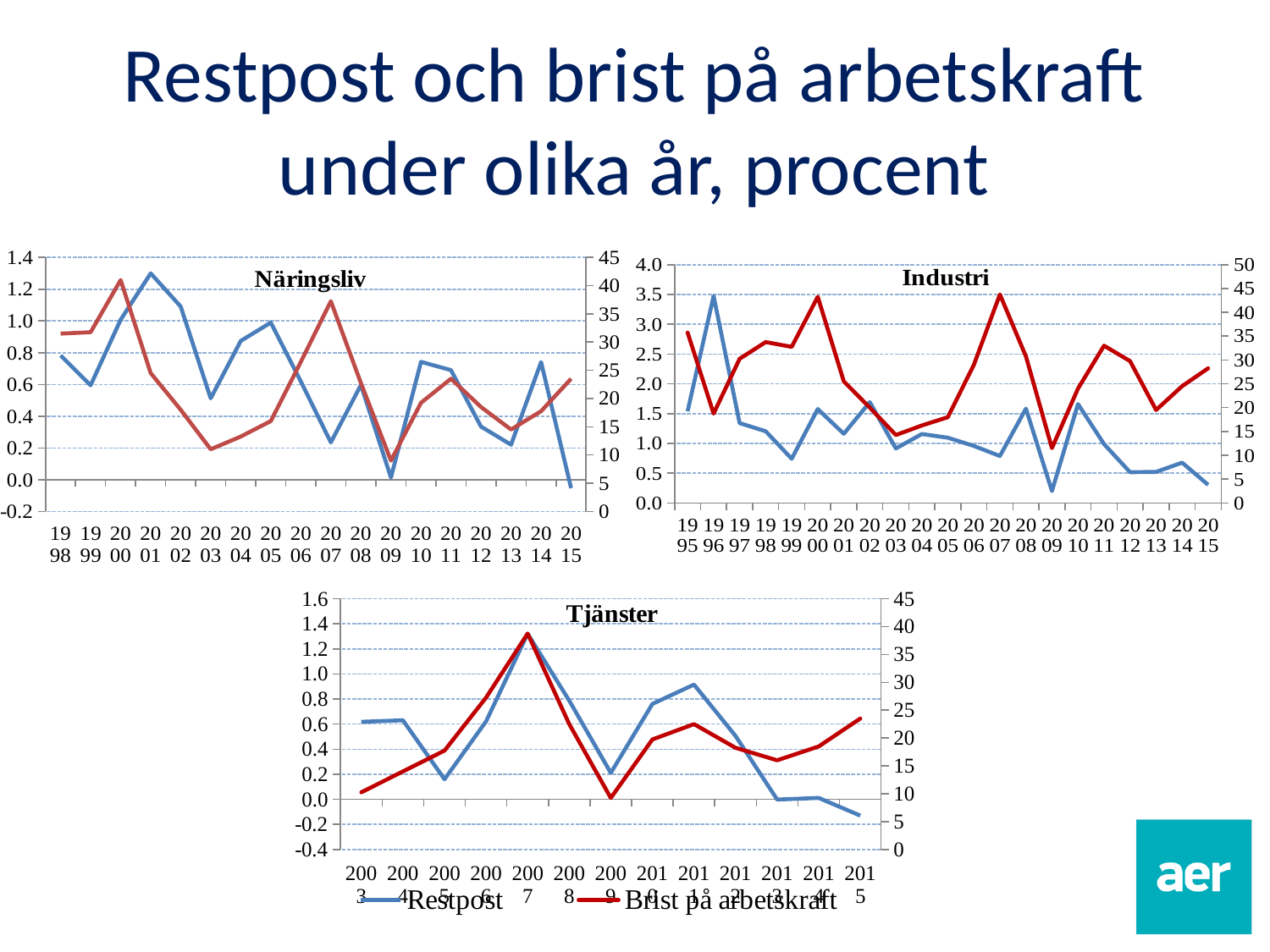
In the Näringsliv chart, which year has the highest Restpost value? 2001 In the Industri chart, how many years are shown on the x axis? 21 How many series does the legend list for the charts on the slide? 2 What kind of chart is the Näringsliv chart? line chart In the Industri chart, which year has the highest Restpost value? 1996 In the Industri chart, which is larger: the Restpost value for 1996 or for 2009? 1996 In the Tjänster chart, is the Brist på arbetskraft value for 2007 greater or less than 35? greater What are the two series named in the legend? Restpost and Brist på arbetskraft In the Näringsliv chart, which year has the lowest Brist på arbetskraft value? 2009 In the Tjänster chart, how many years are shown on the x axis? 13 In the Tjänster chart, which year has the lowest Restpost value? 2015 In the Industri chart, is the Restpost value for 1996 greater or less than 3.0? greater